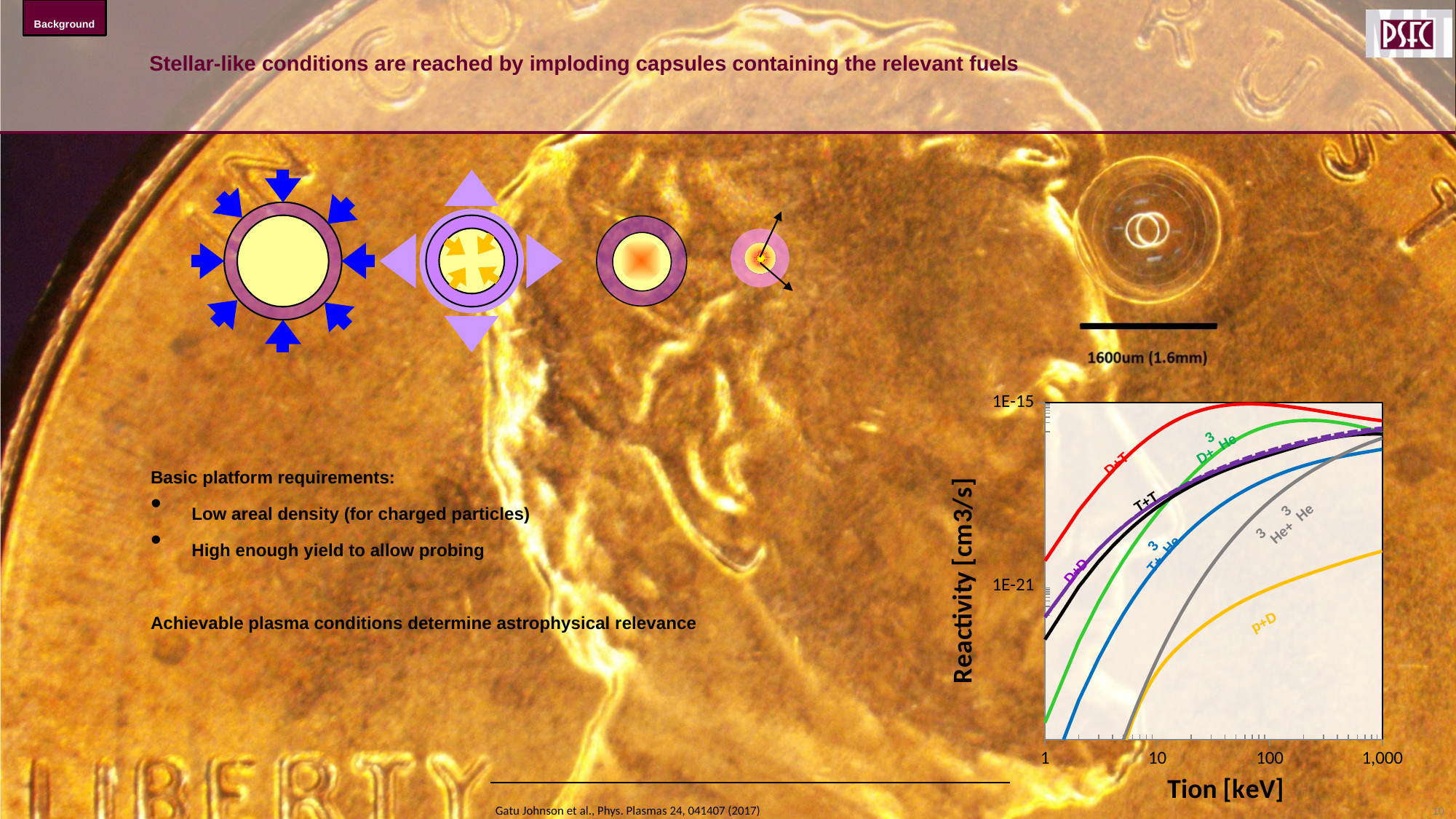
At 10 keV, which has the larger reactivity, D+T or 3He+3He? D+T What kind of chart is shown on the slide? line chart Does the p+D reactivity rise or fall as Tion increases from 10 to 1,000 keV? rise What is the label of the y axis of the reactivity chart? Reactivity [cm3/s] Which reaction has the highest reactivity at 10 keV? D+T Is the reactivity of p+D at 10 keV greater or less than 1E-21? less What is the label of the x axis of the reactivity chart? Tion [keV] Is the reactivity of D+T at 100 keV greater or less than 1E-21? greater At 100 keV, which has the larger reactivity, D+T or p+D? D+T What is the highest Tion value labelled on the x axis? 1,000